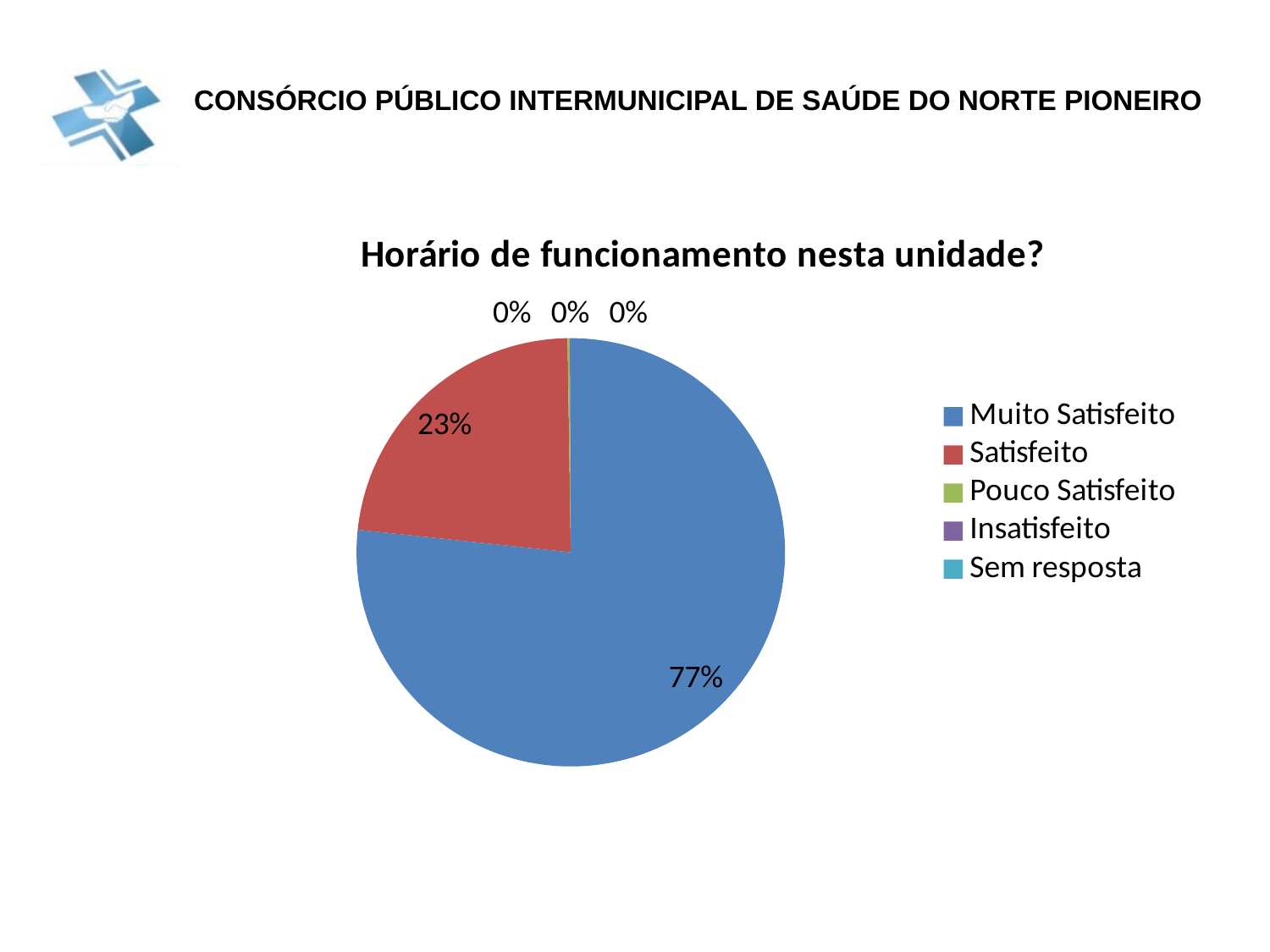
Is the share for Muito Satisfeito greater or less than 50%? greater What is the difference in percentage points between the Muito Satisfeito share and the Satisfeito share? 54 How many slices are labelled 0%? 3 Which colour represents Satisfeito in the legend? red What is the title of the chart? Horário de funcionamento nesta unidade? What share of the pie is labelled for Satisfeito? 23% Which category has the largest slice of the pie? Muito Satisfeito Which is larger, the share for Muito Satisfeito or the share for Satisfeito? Muito Satisfeito What share of the pie is labelled for Muito Satisfeito? 77% What kind of chart is shown on the slide? pie chart What is the combined share of Muito Satisfeito and Satisfeito? 100% How many categories does the legend list? 5